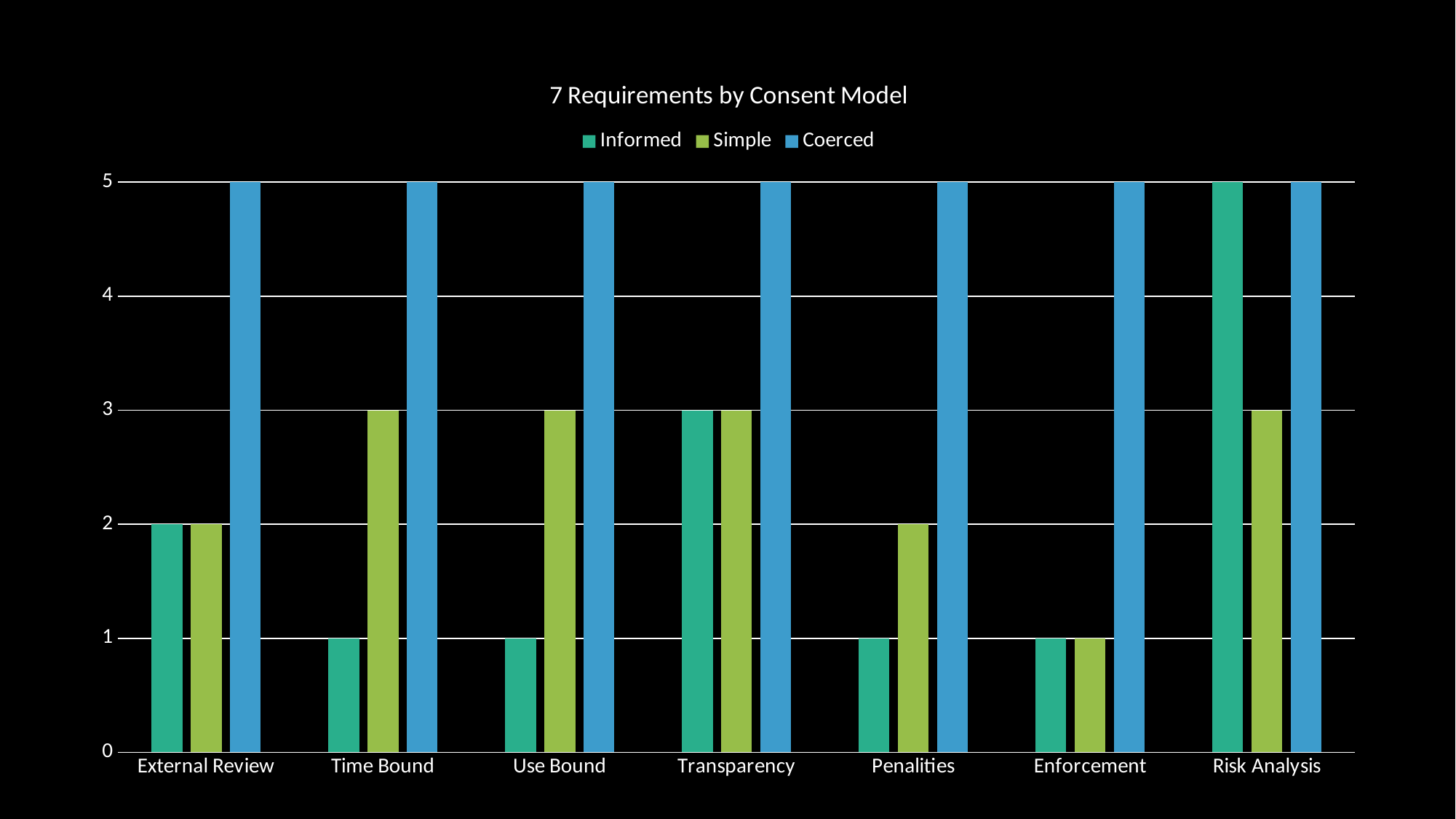
What is the title of the chart? 7 Requirements by Consent Model What is the value for Coerced at Enforcement? 5 What kind of chart is shown on the slide? bar chart How many categories are shown on the x axis? 7 Which is larger at Use Bound, the Informed value or the Simple value? Simple How many series does the legend list? 3 What is the value for Simple at Penalities? 2 Which category has the lowest value for Simple? Enforcement What is the value for Informed at Risk Analysis? 5 What is the value for Informed at Transparency? 3 Which category has the highest value for Informed? Risk Analysis What is the difference between the Coerced and Informed values at Time Bound? 4